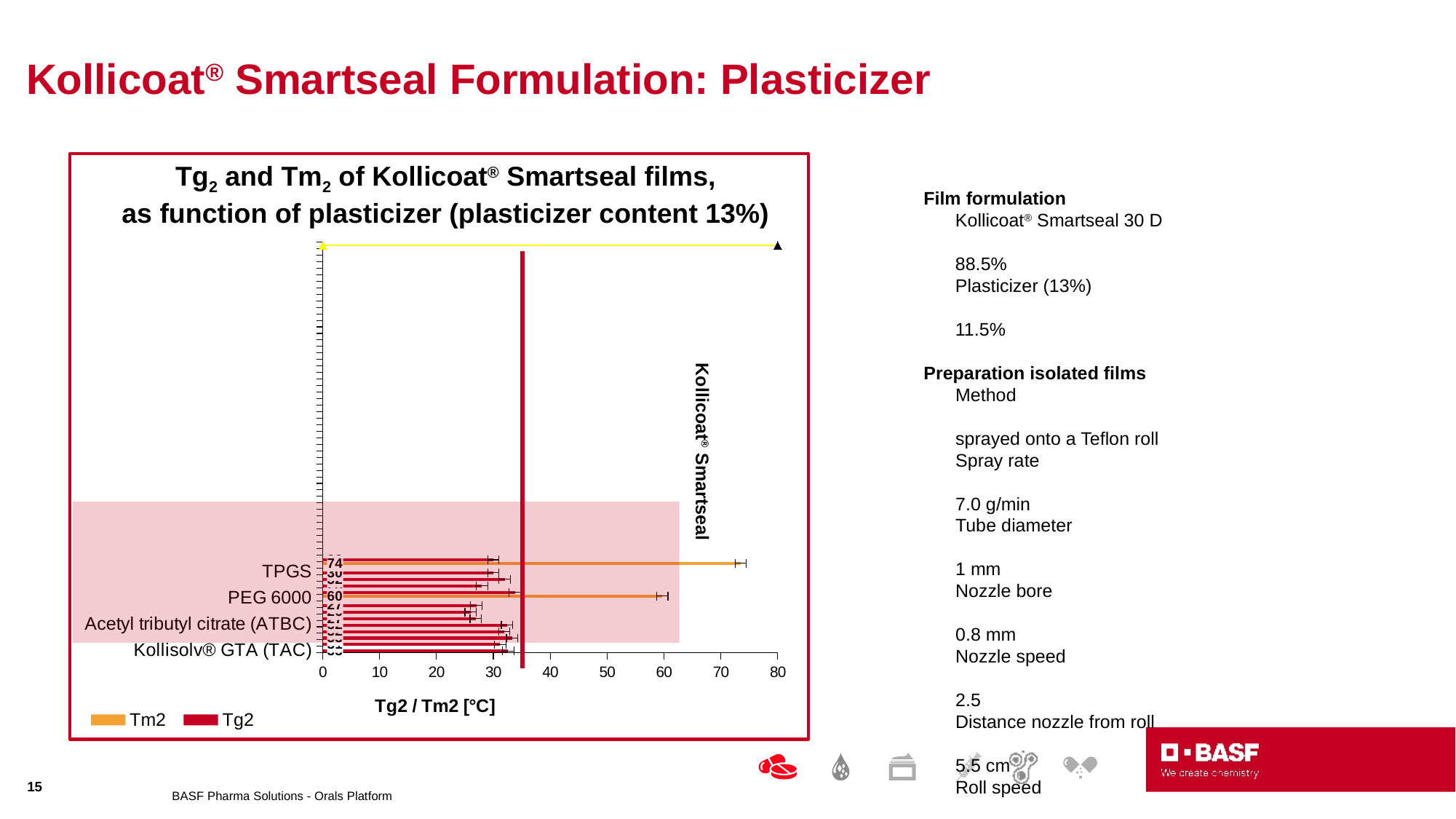
How many series does the chart legend list? 2 What kind of chart is shown on the slide? bar chart What is the highest tick value shown on the horizontal axis? 80 What is the title of the horizontal axis of the chart? Tg2 / Tm2 [°C] Is the Tg2 value for TPGS greater or less than 40? less Is the Tg2 value for Kollisolv® GTA (TAC) greater or less than 20? greater What are the two series named in the chart legend? Tm2 and Tg2 What is the Tm2 value labelled for PEG 6000? 60